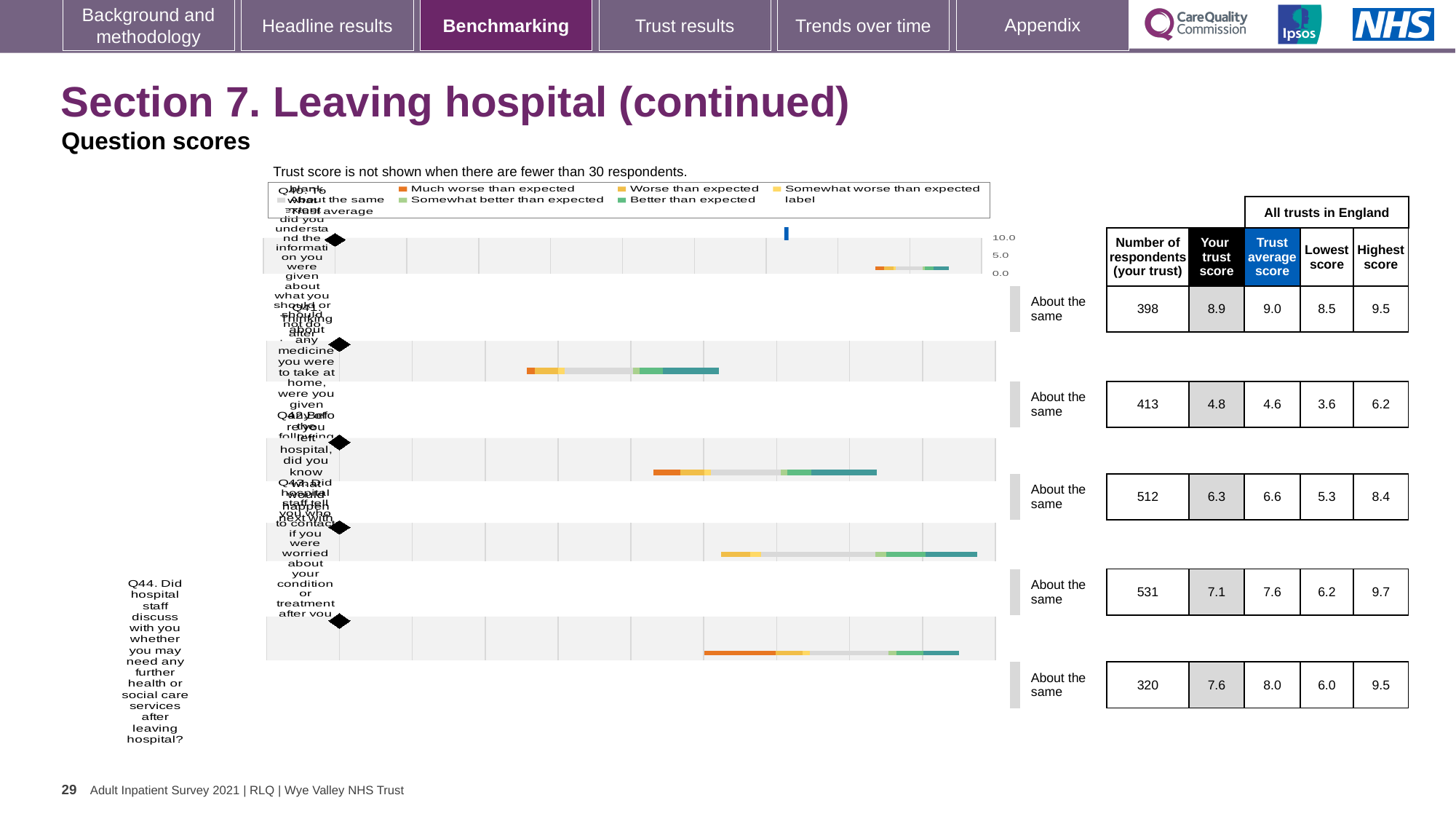
What benchmark category is shown for Q44? About the same For Q44 (discussing further health or social care services after leaving hospital), what is the number of respondents for your trust? 320 For Q44, what is the lowest score among all trusts in England? 6.0 For Q44, is your trust score higher or lower than the trust average score? lower For Q44, what is the highest score among all trusts in England? 9.5 What kind of chart is used to show the question scores on this slide? bar chart How many question rows are plotted in the benchmarking chart? 5 Which question row has the largest number of respondents in the table? the fourth row (531 respondents) According to the note above the chart, below how many respondents is the trust score not shown? fewer than 30 respondents For Q44, what is the trust average score for all trusts in England? 8.0 For Q44, what is the difference between the highest score and the lowest score across all trusts in England? 3.5 For Q44, what is your trust score? 7.6